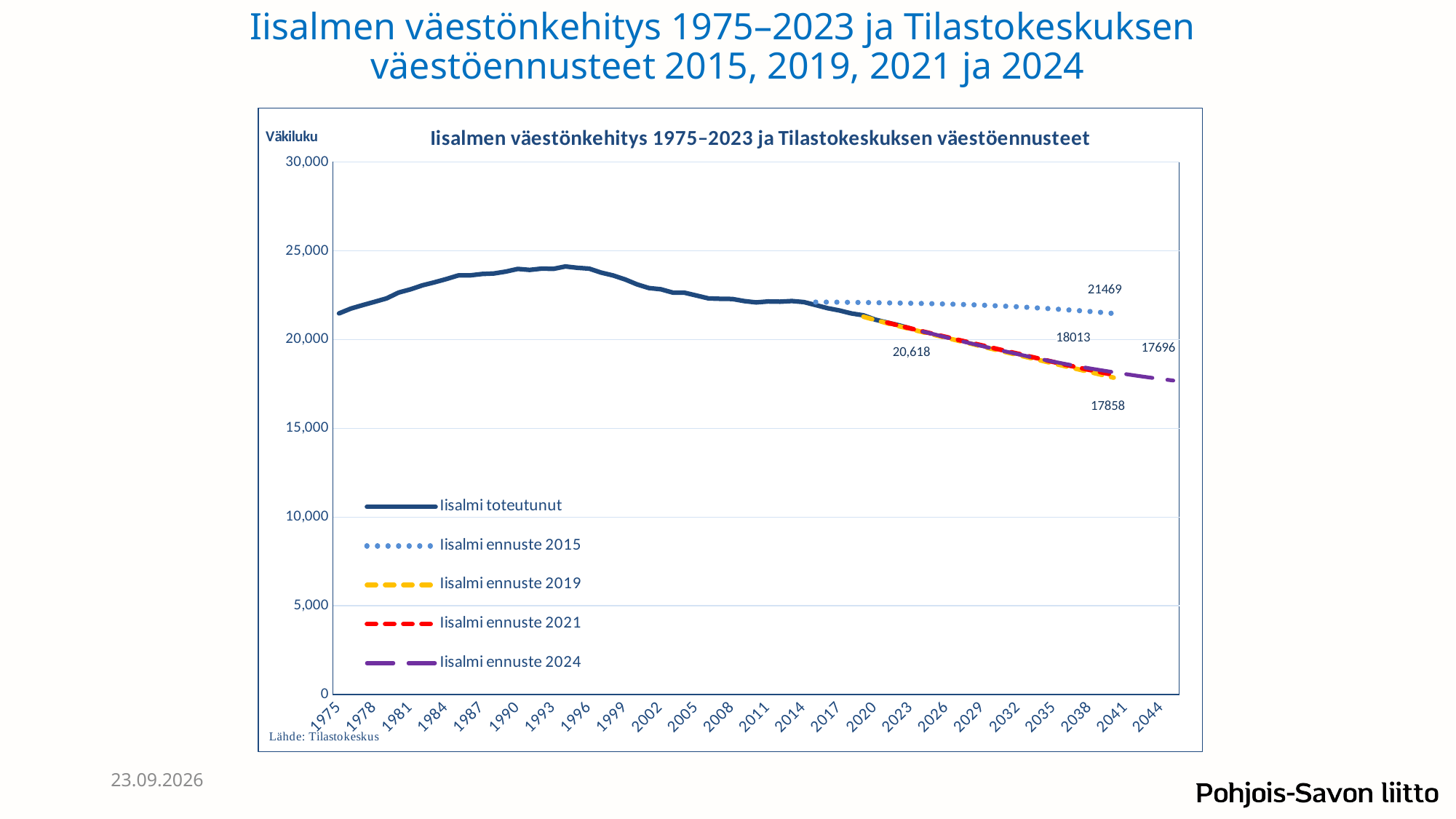
Does the Iisalmi toteutunut series rise or fall between 2000 and 2023? fall Is the Iisalmi toteutunut value in 1993 greater or less than 25,000? less What is the difference between the labelled end values of Iisalmi ennuste 2015 (21469) and Iisalmi ennuste 2024 (17696)? 3773 Which forecast series ends at a higher value, Iisalmi ennuste 2015 or Iisalmi ennuste 2024? Iisalmi ennuste 2015 What is the labelled end value of the Iisalmi ennuste 2024 series? 17696 What is the labelled end value of the Iisalmi ennuste 2015 series? 21469 Is the Iisalmi toteutunut value in 1975 greater or less than 20,000? greater Which forecast series ends at the highest value? Iisalmi ennuste 2015 What kind of chart is shown on the slide? line chart What is the title of the chart? Iisalmen väestönkehitys 1975–2023 ja Tilastokeskuksen väestöennusteet Which series is drawn with a purple dashed line? Iisalmi ennuste 2024 How many series does the chart legend list? 5